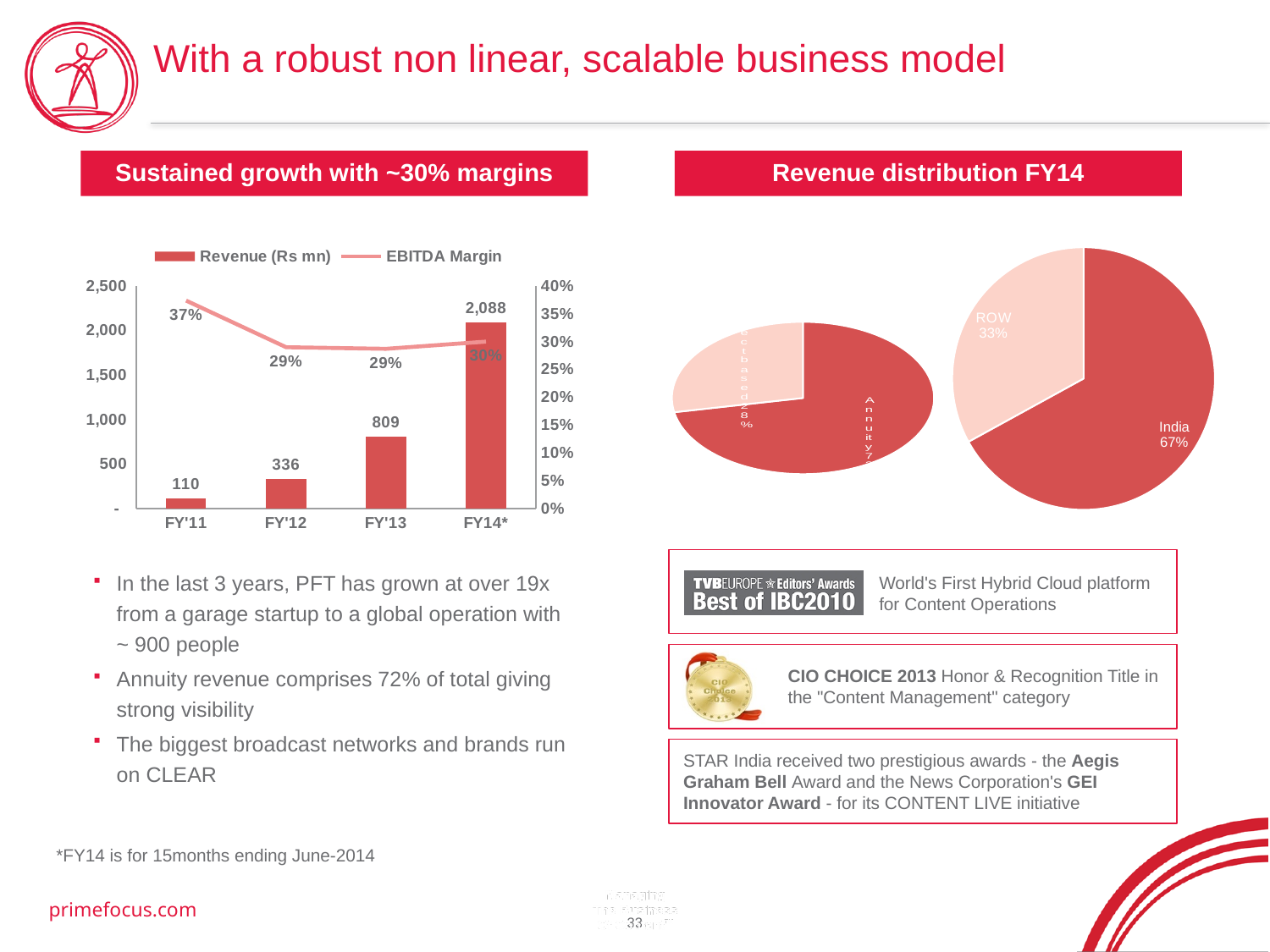
In the 'Sustained growth with ~30% margins' chart, what is the Revenue (Rs mn) for FY'13? 809 In the 'Sustained growth with ~30% margins' chart, what is the EBITDA Margin for FY'11? 37% In the 'Revenue distribution FY14' pie chart on the right, what share of revenue comes from India? 67% In the 'Sustained growth with ~30% margins' chart, what is the EBITDA Margin for FY14*? 30% In the 'Sustained growth with ~30% margins' chart, what is the difference in Revenue (Rs mn) between FY14* and FY'13? 1,279 In the 'Revenue distribution FY14' pie chart on the right, which slice is larger, India or ROW? India In the 'Sustained growth with ~30% margins' chart, which year has the highest Revenue (Rs mn)? FY14* In the 'Sustained growth with ~30% margins' chart, which year has higher Revenue (Rs mn), FY'12 or FY'13? FY'13 How many fiscal years are shown on the x axis of the 'Sustained growth with ~30% margins' chart? 4 In the 'Sustained growth with ~30% margins' chart, which year has the lowest Revenue (Rs mn)? FY'11 How many series does the legend of the 'Sustained growth with ~30% margins' chart list? 2 In the 'Sustained growth with ~30% margins' chart, does Revenue (Rs mn) rise or fall from FY'11 to FY14*? Rise